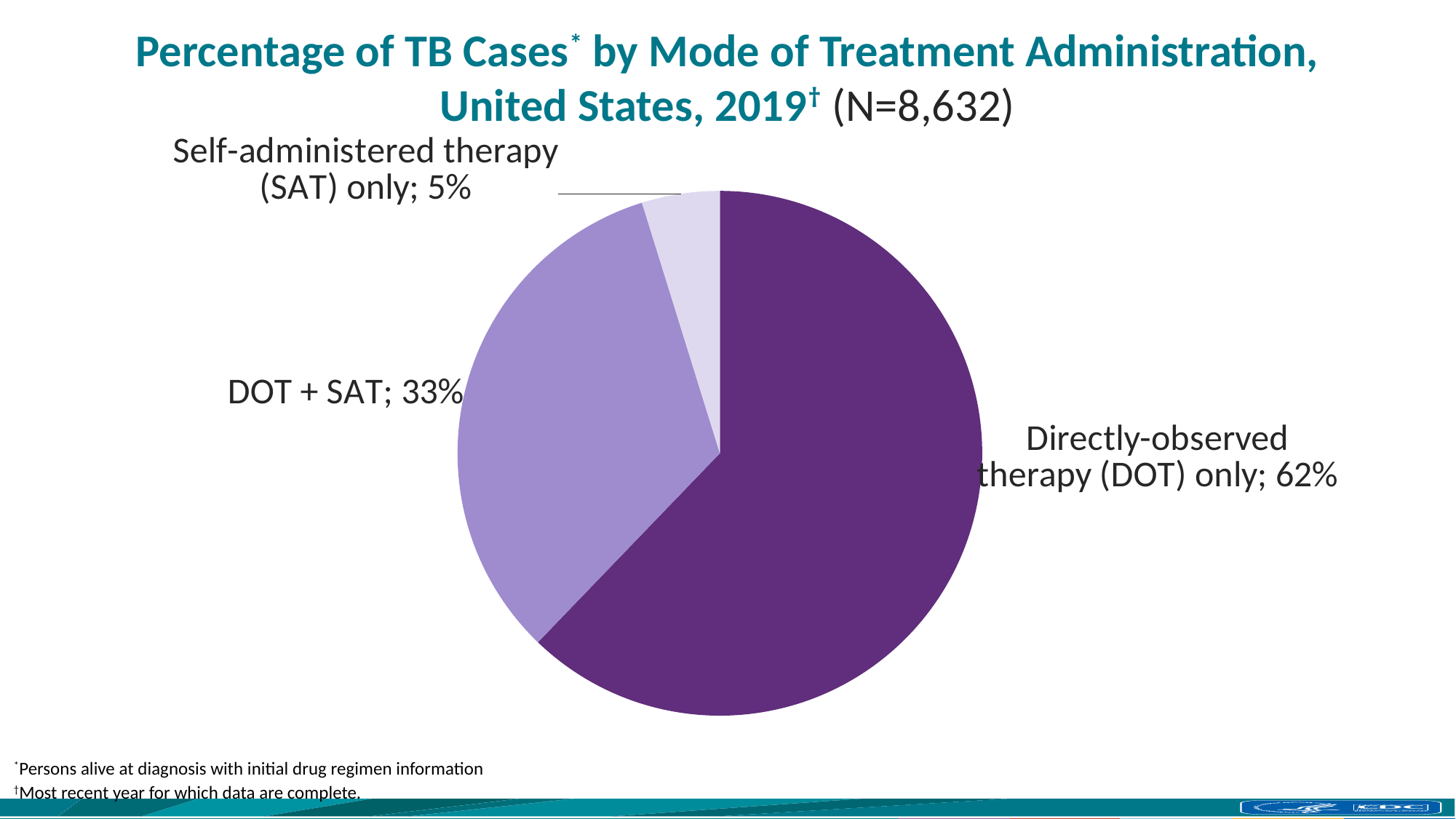
What is the difference in percentage points between DOT + SAT and SAT only? 28 Which mode of treatment administration has the smallest share of TB cases? Self-administered therapy (SAT) only What is the total number of TB cases (N) shown in the chart title? 8,632 Which is larger: the share for DOT + SAT or the share for SAT only? DOT + SAT Which mode of treatment administration has the largest share of TB cases? Directly-observed therapy (DOT) only How many slices does the pie chart have? 3 Which year does the chart cover? 2019 What is the difference in percentage points between DOT only and DOT + SAT? 29 What percentage of TB cases were treated with DOT + SAT? 33% What percentage of TB cases were treated with directly-observed therapy (DOT) only? 62% What kind of chart is shown on the slide? Pie chart What percentage of TB cases were treated with self-administered therapy (SAT) only? 5%